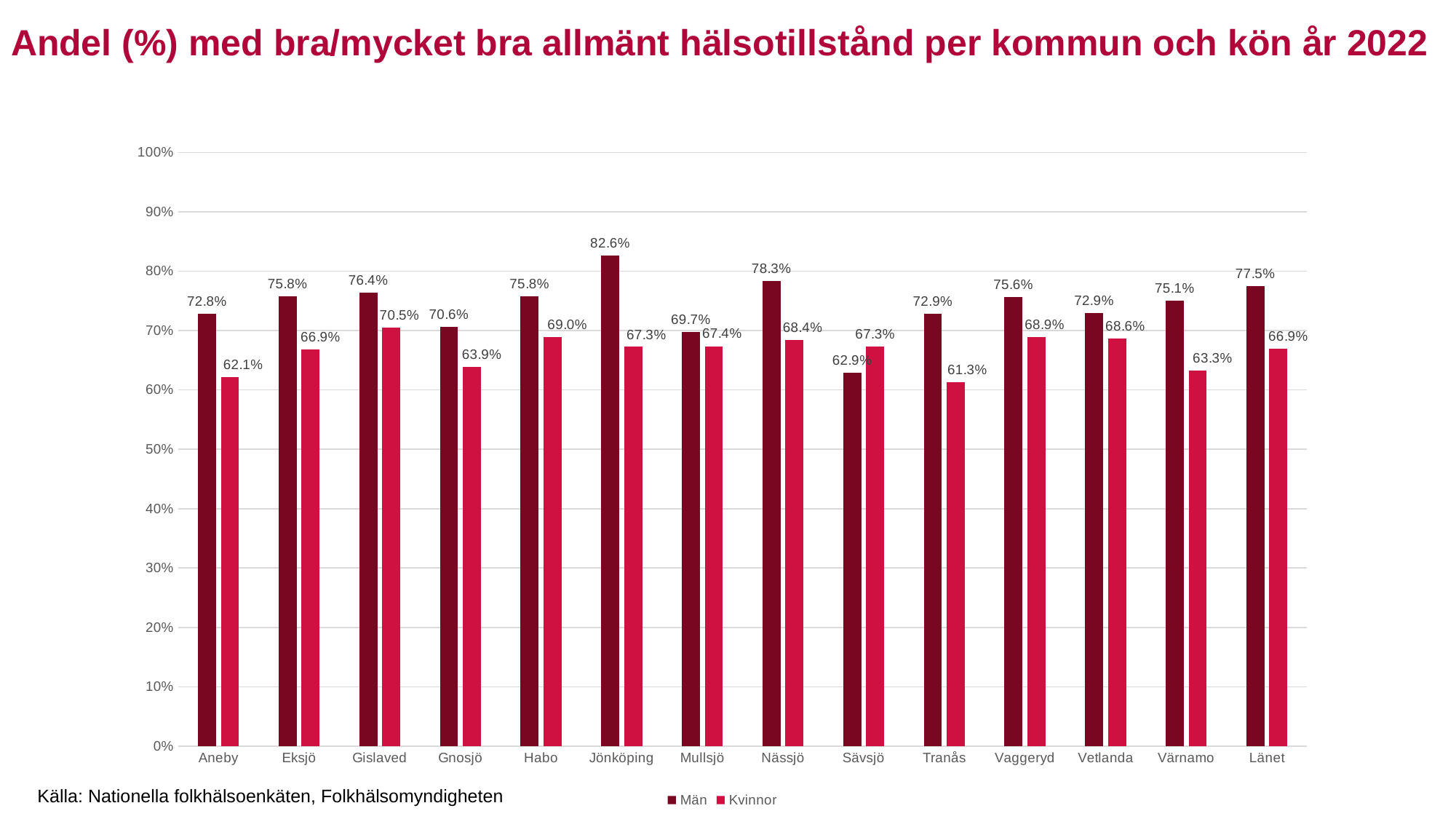
Is the value for Kvinnor in Aneby greater or less than 70%? less Which municipality has the highest value for Män? Jönköping What is the value for Män in Jönköping? 82.6% What kind of chart is shown on the slide? Bar chart What is the value for Kvinnor in Länet? 66.9% In Sävsjö, which is larger: the value for Män or for Kvinnor? Kvinnor Which municipality has the lowest value for Kvinnor? Tranås What is the difference between Män and Kvinnor in Jönköping? 15.3 percentage points Which municipality has the lowest value for Män? Sävsjö What is the value for Kvinnor in Gislaved? 70.5% How many categories are shown on the x axis? 14 How many series does the legend list? 2